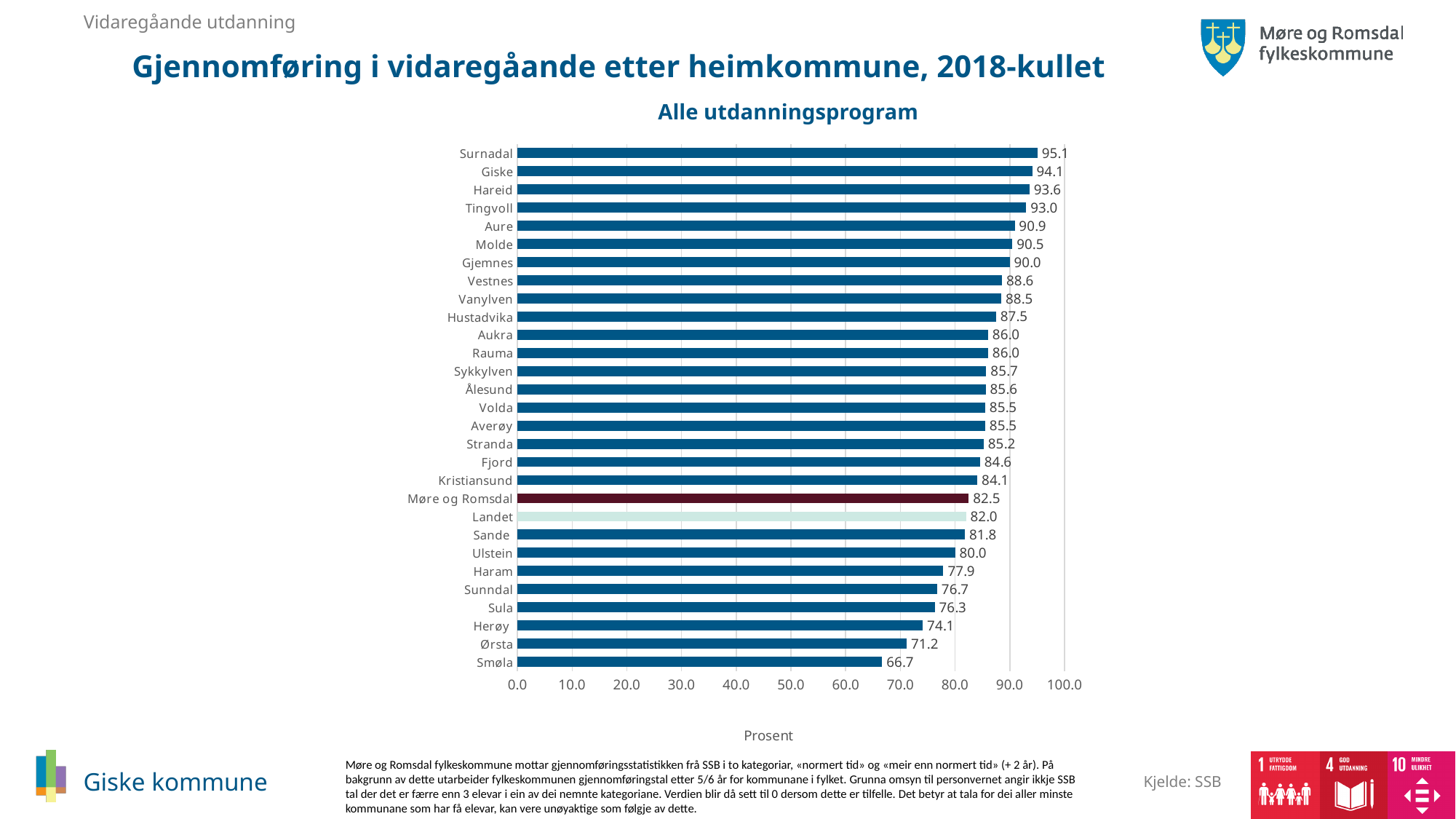
What is the value for Giske? 94.1 What kind of chart is shown on the slide? bar chart Which has a higher value, Molde or Ålesund? Molde How many bars are shown in the chart? 29 What is the value for Møre og Romsdal? 82.5 What is the title of the chart? Alle utdanningsprogram Which category has the highest value? Surnadal Which category has the lowest value? Smøla Is the value for Ørsta greater or less than 80.0? less What is the difference between the values for Surnadal and Smøla? 28.4 What is the difference between the values for Giske and Landet? 12.1 What is the value for Landet? 82.0